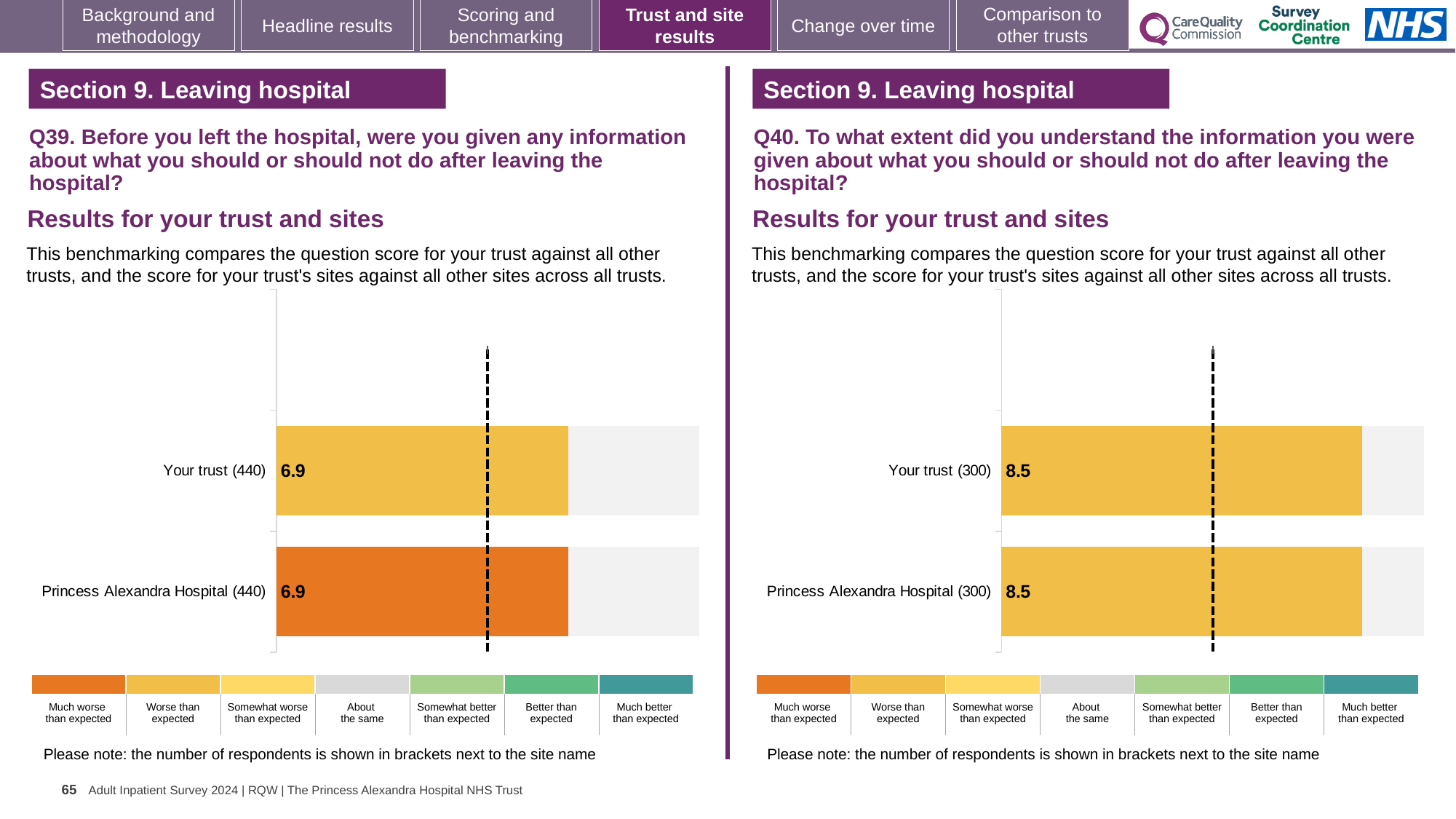
How many bars are plotted in the Q40 chart on the right? 2 How many bars are plotted in the Q39 chart on the left? 2 What type of chart is used for the Q39 results on the left? Bar chart In the Q40 chart on the right, what is the difference between the Your trust score and the Princess Alexandra Hospital score? 0 In the Q39 chart on the left, what is the score for Princess Alexandra Hospital? 6.9 In the Q40 chart on the right, what is the score for Princess Alexandra Hospital? 8.5 In the Q39 chart on the left, which benchmark category does the colour of the Princess Alexandra Hospital bar correspond to in the legend? Much worse than expected In the Q39 chart on the left, what is the score for Your trust? 6.9 In the Q40 chart on the right, how many respondents are shown in brackets next to Your trust? 300 In the Q40 chart on the right, what is the score for Your trust? 8.5 In the Q39 chart on the left, what is the difference between the Your trust score and the Princess Alexandra Hospital score? 0 In the Q39 chart on the left, how many respondents are shown in brackets next to Princess Alexandra Hospital? 440